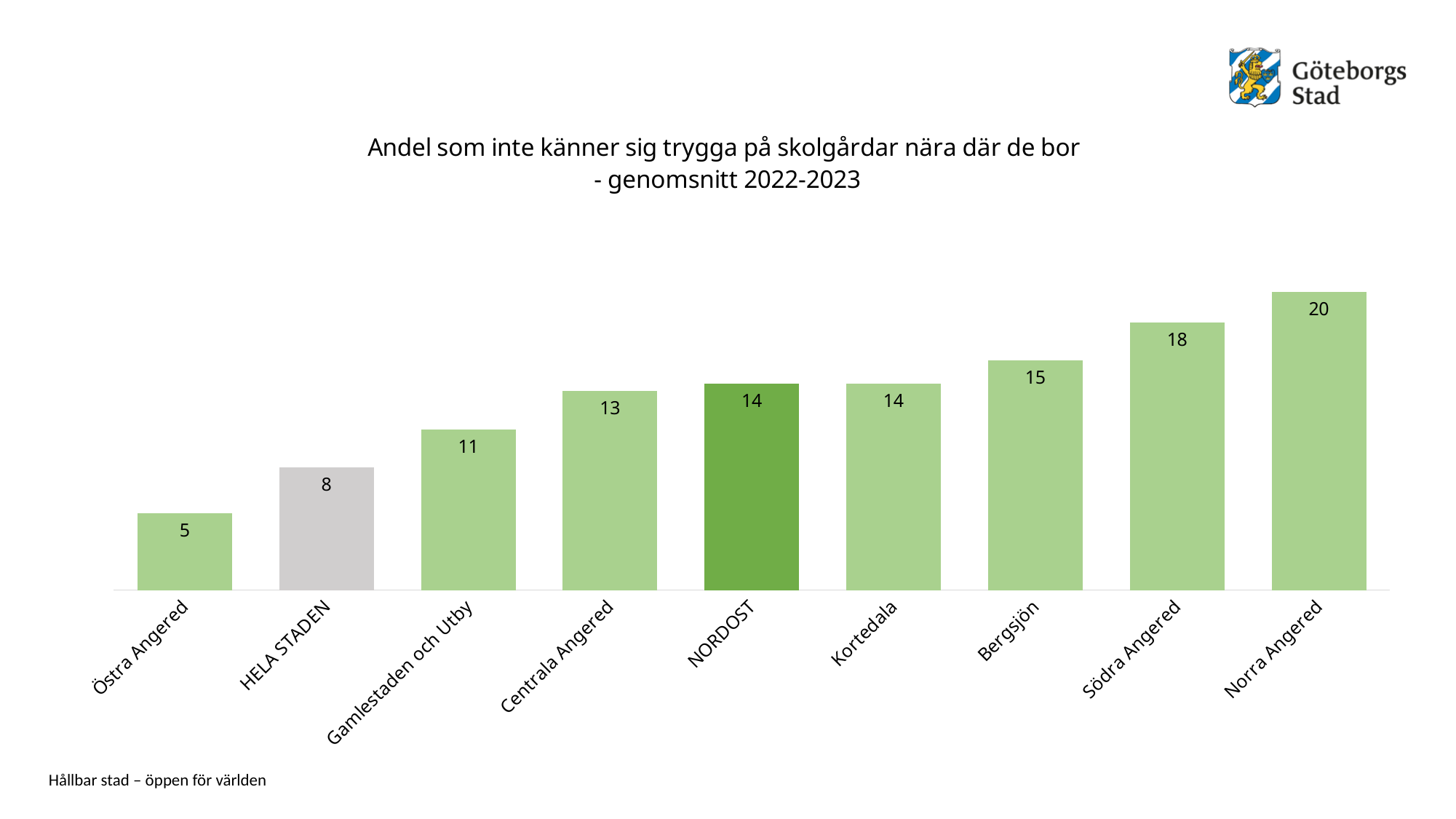
Which is larger, the value for Bergsjön or the value for Centrala Angered? Bergsjön Which category has the highest value? Norra Angered What is the difference between the values for Norra Angered and Östra Angered? 15 What is the value for HELA STADEN? 8 What kind of chart is shown on the slide? Bar chart Which category has the lowest value? Östra Angered What is the value for NORDOST? 14 What is the value for Norra Angered? 20 What is the value for Gamlestaden och Utby? 11 How many categories are shown in the chart? 9 What is the difference between the values for Södra Angered and HELA STADEN? 10 Do the values rise or fall from left to right along the x axis? Rise